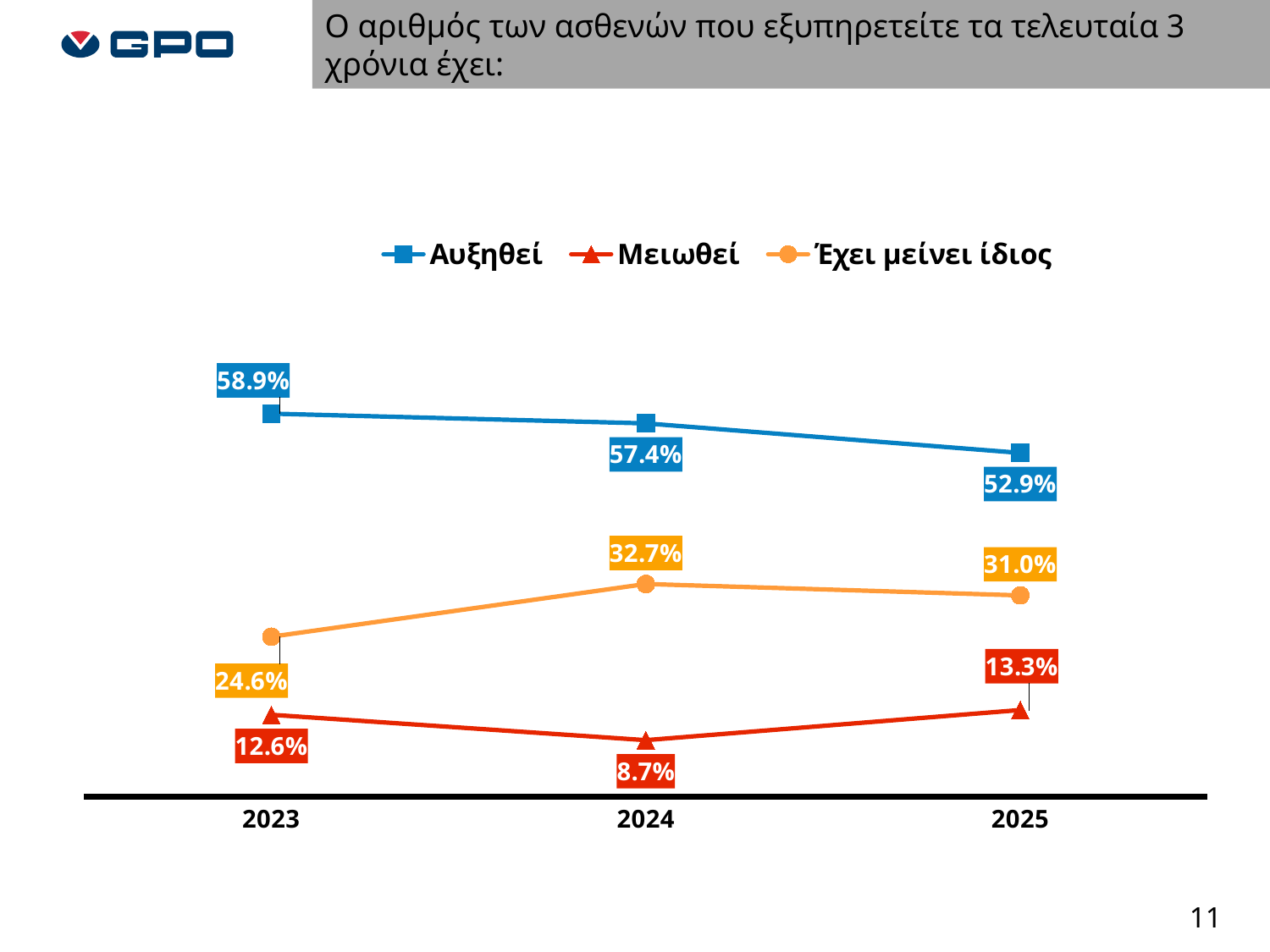
Which colour is used for the Μειωθεί series? Red How many years are shown on the x axis? 3 What kind of chart is shown on the slide? Line chart What is the difference between the Αυξηθεί values for 2023 and 2025? 6.0% What is the value for Έχει μείνει ίδιος in 2025? 31.0% Does the value for Αυξηθεί rise or fall from 2023 to 2025? Fall What is the value for Αυξηθεί in 2023? 58.9% In which year is the value for Έχει μείνει ίδιος highest? 2024 What is the value for Μειωθεί in 2024? 8.7% How many series does the legend list? 3 In which year is the value for Μειωθεί lowest? 2024 Which is larger in 2025: the value for Μειωθεί or the value for Έχει μείνει ίδιος? Έχει μείνει ίδιος